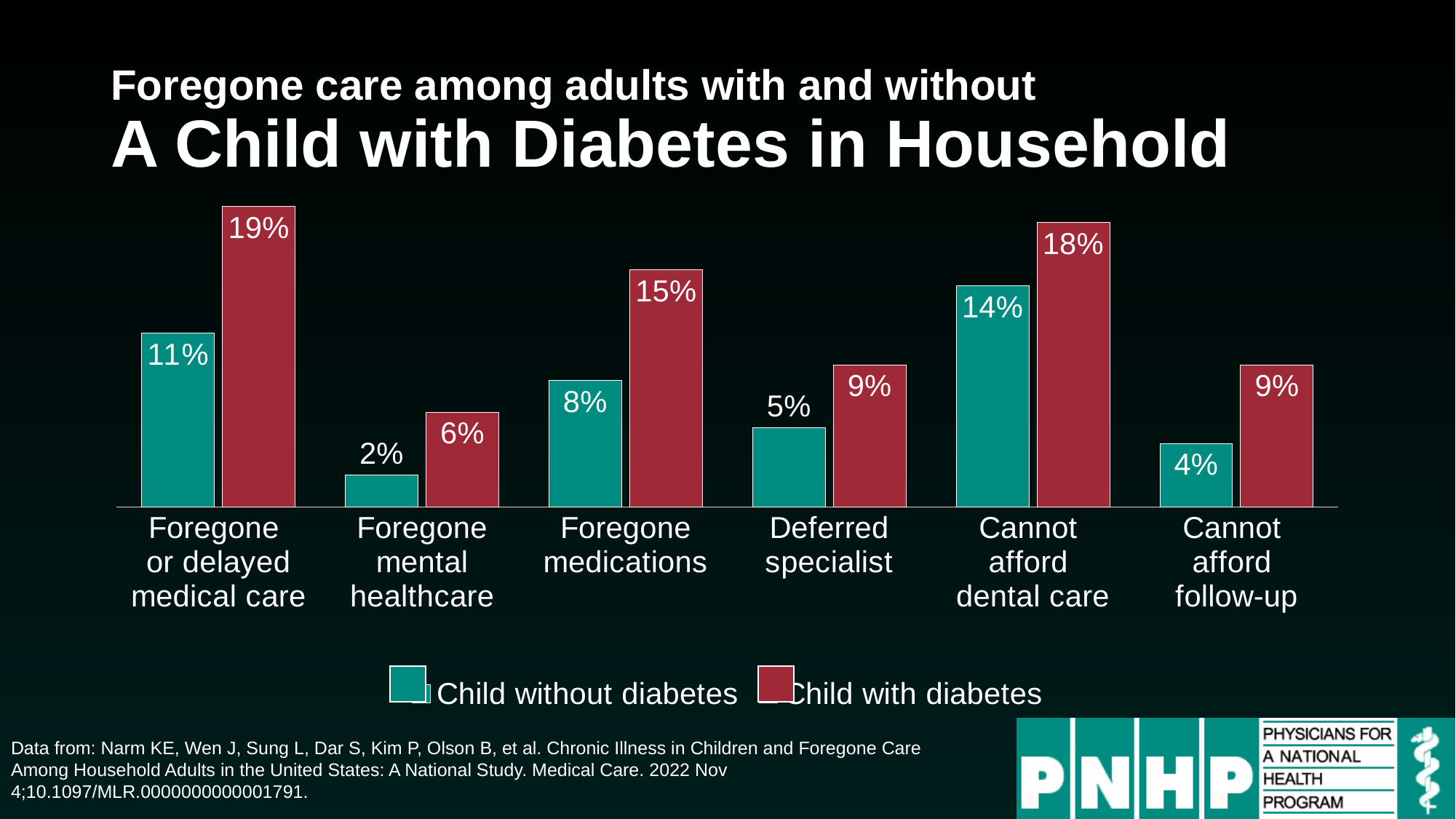
What percentage of adults with a child with diabetes reported foregone or delayed medical care? 19% What is the value for 'Child with diabetes' in the 'Foregone medications' category? 15% What kind of chart is shown on the slide? Bar chart How many categories are shown on the x axis? 6 How many series does the legend list? 2 Which category has the lowest value for the 'Child without diabetes' series? Foregone mental healthcare What is the difference between the 'Child with diabetes' and 'Child without diabetes' values for 'Foregone medications'? 7% Which is larger: the 'Child without diabetes' value for 'Cannot afford dental care' or the 'Child with diabetes' value for 'Foregone medications'? Child with diabetes value for Foregone medications (15%) What is the value for 'Child without diabetes' in the 'Cannot afford dental care' category? 14% What is the difference between the two series in the 'Cannot afford follow-up' category? 5% Which colour represents the 'Child with diabetes' series? Red Which category has the highest value for the 'Child with diabetes' series? Foregone or delayed medical care